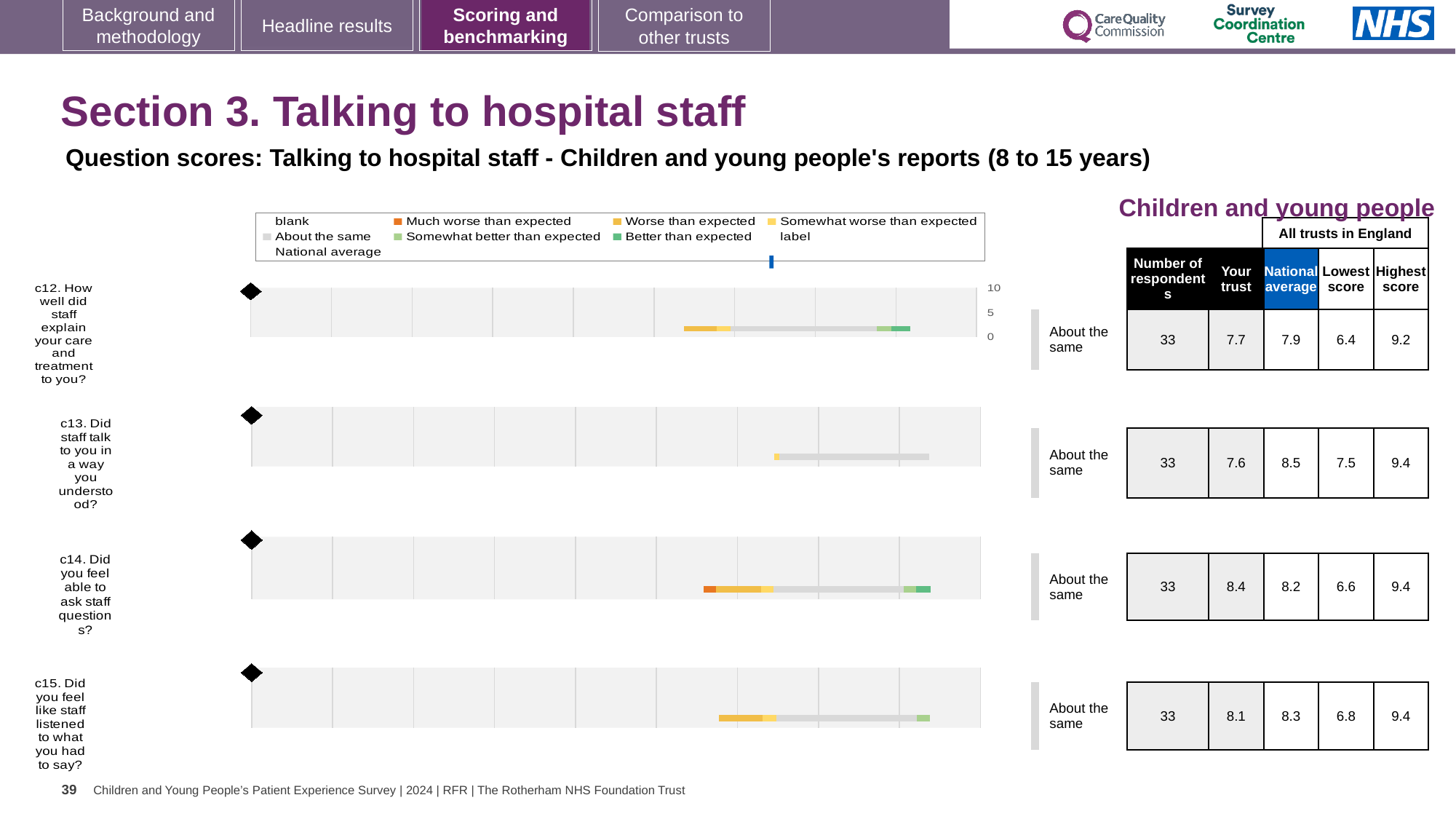
How many questions (c12 to c15) have a benchmarking chart on this slide? 4 Which question has the highest 'Your trust' score? c14. Did you feel able to ask staff questions? What kind of chart is used to show the benchmarking results for each question on this slide? bar chart What is the lowest score across all trusts in England for c15 (Did you feel like staff listened to what you had to say?)? 6.8 For c14, which is larger: the 'Your trust' score or the national average? Your trust How many respondents answered question c12? 33 What is the difference between the national average and the 'Your trust' score for c12? 0.2 What is the highest score across all trusts in England for c14 (Did you feel able to ask staff questions?)? 9.4 What is the 'Your trust' score for c12 (How well did staff explain your care and treatment to you?)? 7.7 What is the national average score for c13 (Did staff talk to you in a way you understood?)? 8.5 What benchmark category is shown next to the chart for c15? About the same Which question has the lowest 'Your trust' score? c13. Did staff talk to you in a way you understood?